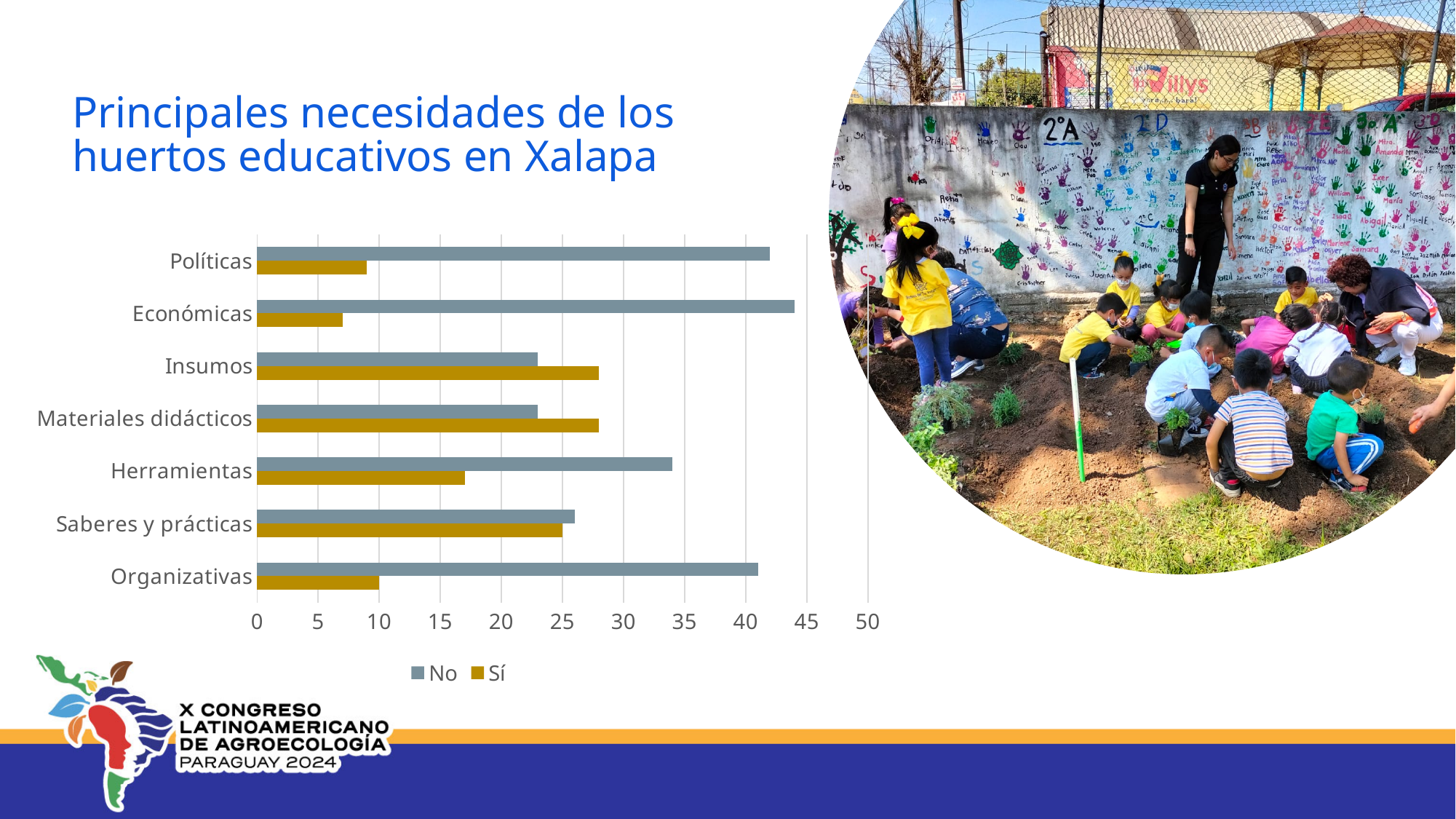
Is the 'No' value for Materiales didácticos greater or less than 25? less Which series is shown in gold/yellow in the chart? Sí For Insumos, which series has the larger value, No or Sí? Sí Is the 'No' value for Herramientas greater or less than 30? greater Is the 'No' value for Políticas greater or less than 40? greater How many series does the chart legend list? 2 What is the title of the chart on the slide? Principales necesidades de los huertos educativos en Xalapa What kind of chart is shown on the slide? Bar chart How many categories are shown on the chart? 7 For Herramientas, which series has the larger value, No or Sí? No